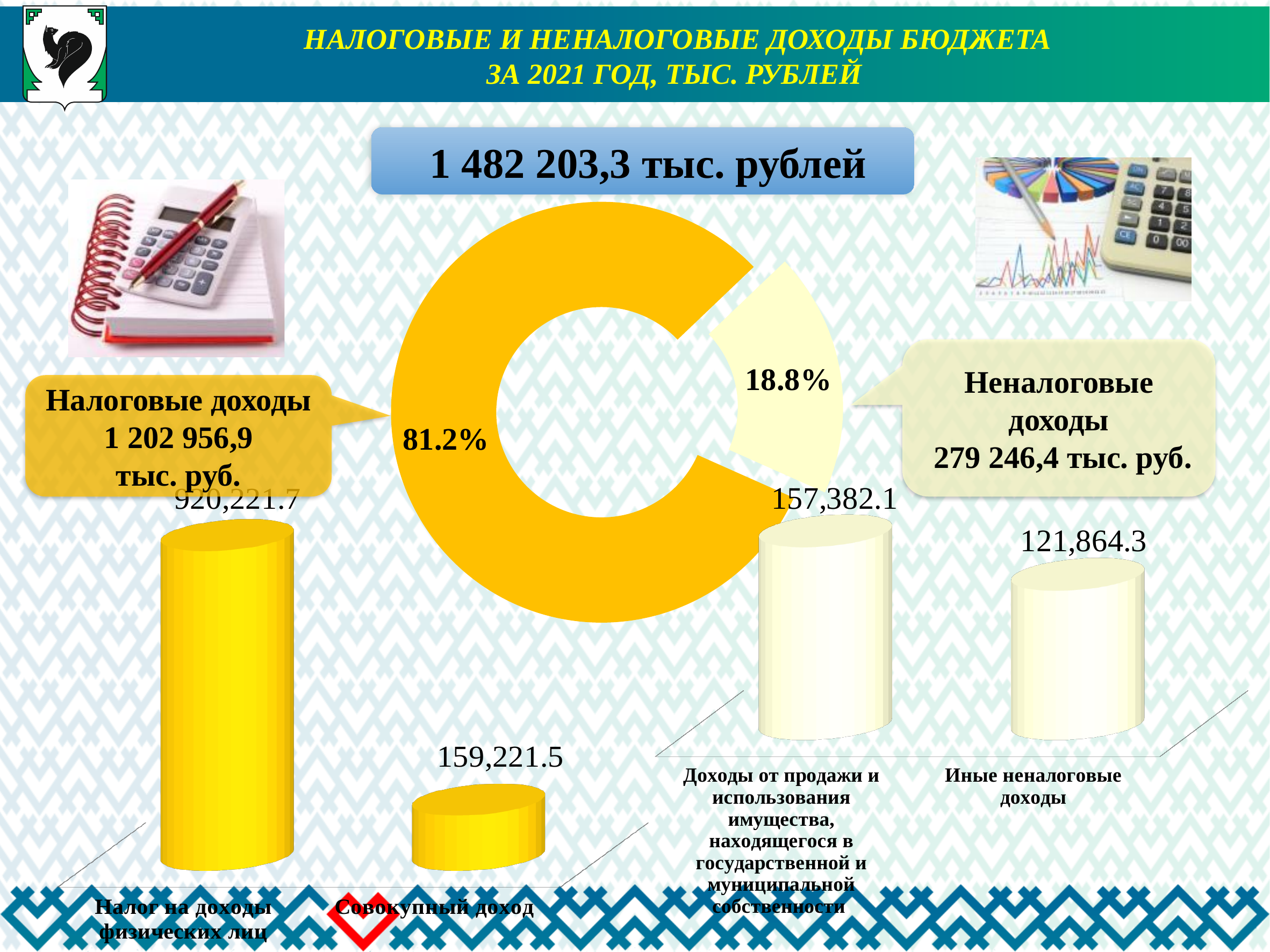
How many segments does the donut chart in the centre have? 2 On the bar chart at the bottom left, what is the difference between Налог на доходы физических лиц and Совокупный доход? 761,000.2 On the donut chart in the centre, what share is shown for the larger (orange) segment? 81.2% On the bar chart at the bottom left, what is the value for Налог на доходы физических лиц? 920,221.7 On the bar chart at the bottom right, what is the value for Доходы от продажи и использования имущества, находящегося в государственной и муниципальной собственности? 157,382.1 On the bar chart at the bottom right, which category has the lower value? Иные неналоговые доходы On the bar chart at the bottom right, what is the difference between the two bars? 35,517.8 What kind of chart is the one in the centre of the slide showing 81.2% and 18.8%? Donut (pie) chart On the bar chart at the bottom right, what is the value for Иные неналоговые доходы? 121,864.3 On the bar chart at the bottom left, what is the value for Совокупный доход? 159,221.5 On the bar chart at the bottom left, which category has the higher value? Налог на доходы физических лиц On the donut chart in the centre, what share is shown for the smaller (pale) segment? 18.8%